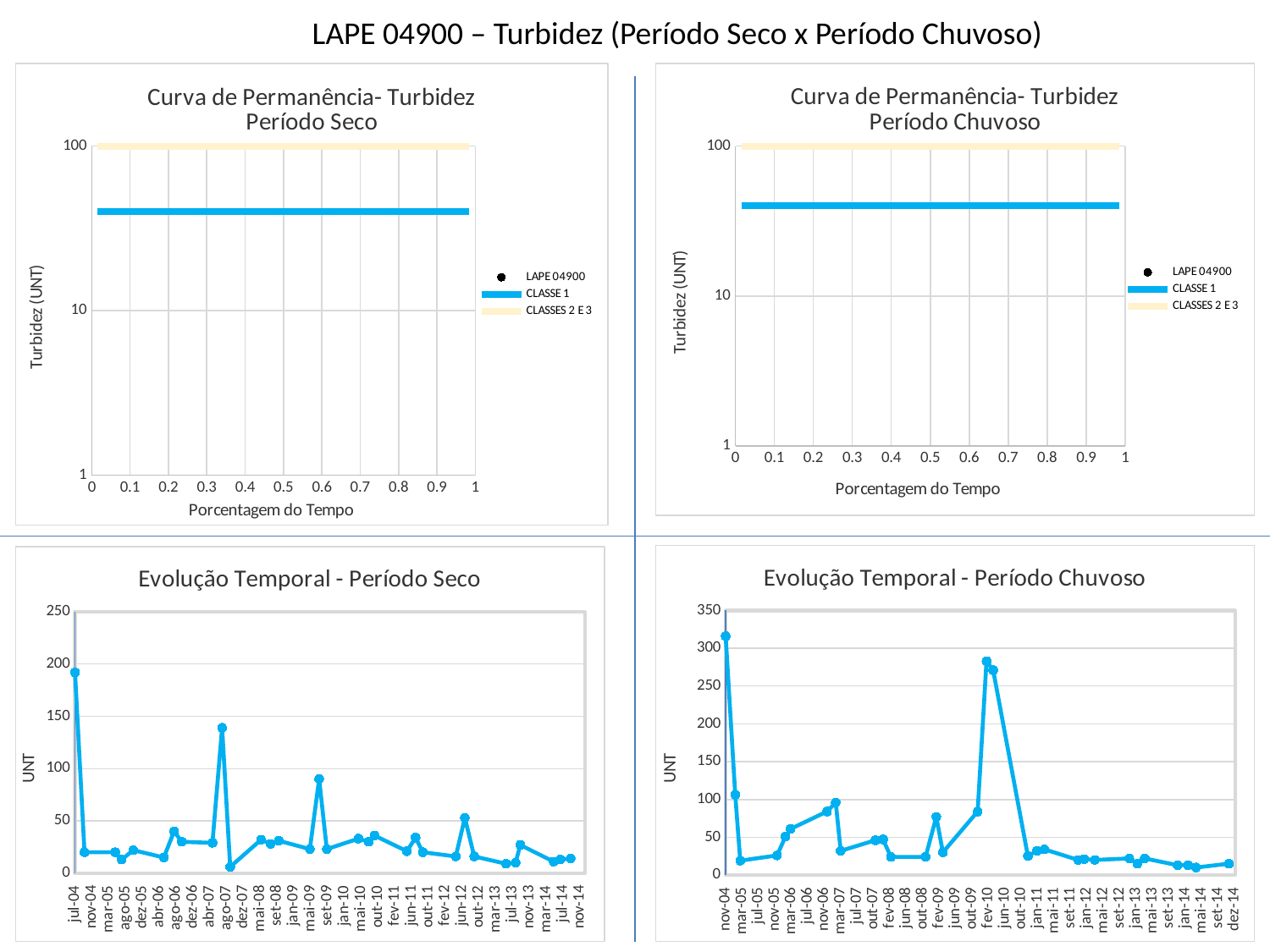
In the 'Evolução Temporal - Período Seco' chart, is the value for ago-07 greater or less than 100? greater In the 'Evolução Temporal - Período Seco' chart, which is larger, the value for jul-04 or the value for ago-07? jul-04 In the 'Curva de Permanência- Turbidez Período Seco' chart, how many series does the legend list? 3 In the 'Evolução Temporal - Período Chuvoso' chart, is the value for fev-10 greater or less than 250? greater In the 'Evolução Temporal - Período Seco' chart, which date has the highest value? jul-04 In the 'Curva de Permanência- Turbidez Período Chuvoso' chart, what is the x-axis title? Porcentagem do Tempo What kind of chart is the 'Evolução Temporal - Período Seco' chart? line chart In the 'Curva de Permanência- Turbidez Período Seco' chart, what is the y-axis label? Turbidez (UNT) In the 'Evolução Temporal - Período Chuvoso' chart, which date has the highest value? nov-04 In the 'Evolução Temporal - Período Chuvoso' chart, is the value for mar-05 greater or less than 50? less